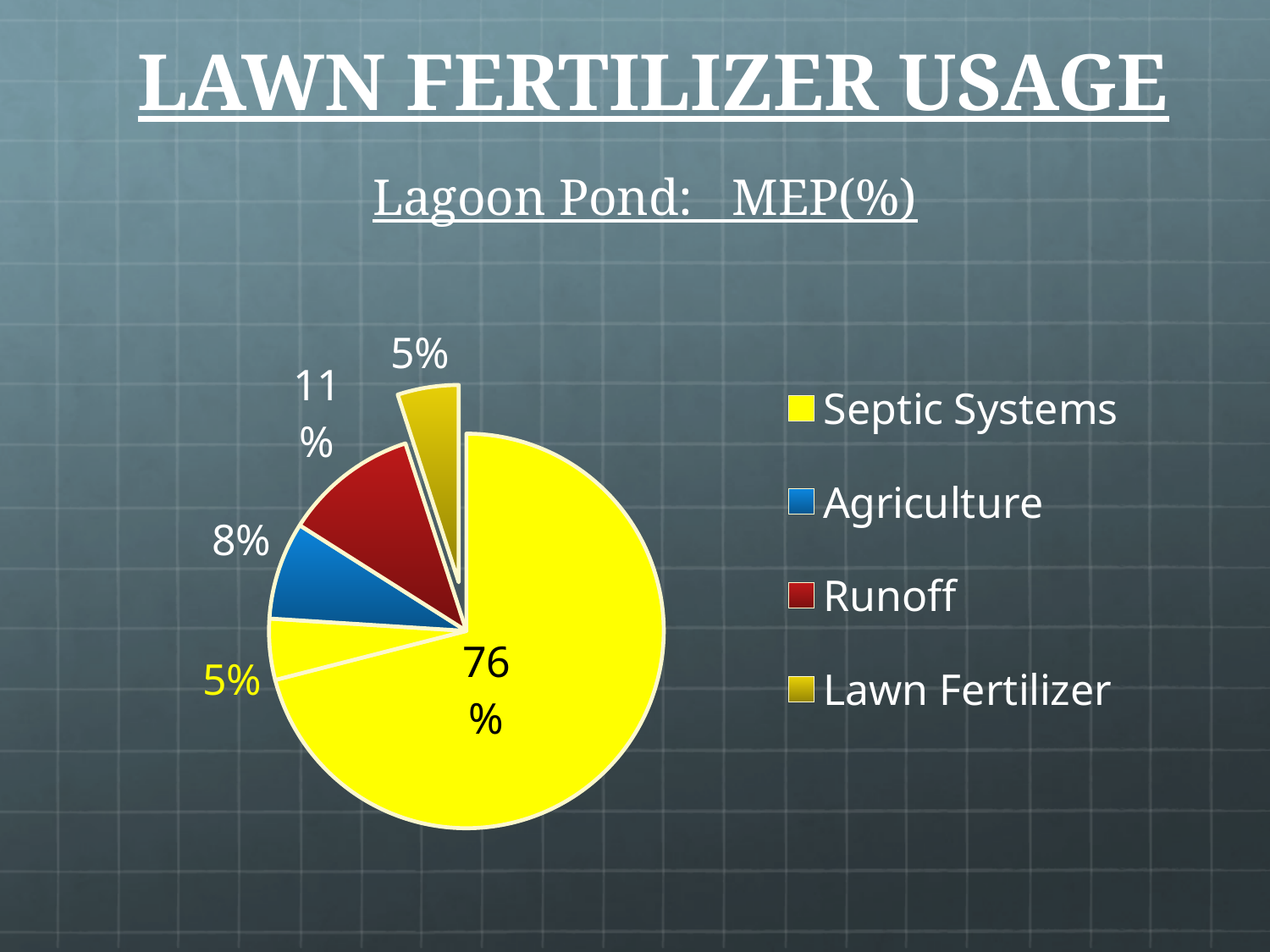
Which slice is pulled out from the rest of the pie? Lawn Fertilizer How many entries does the legend list? 4 What kind of chart is shown on the slide? pie chart How many percentage points larger is the Runoff share than the Agriculture share? 3 What percentage of the pie is Agriculture? 8% What percentage of the pie is Lawn Fertilizer? 5% What colour is the Runoff slice? red What percentage of the pie is Runoff? 11% What percentage of the pie is Septic Systems? 76% Which category has the largest share of the pie? Septic Systems Which is larger, the share for Runoff or the share for Agriculture? Runoff How many percentage points larger is the Septic Systems share than the Runoff share? 65